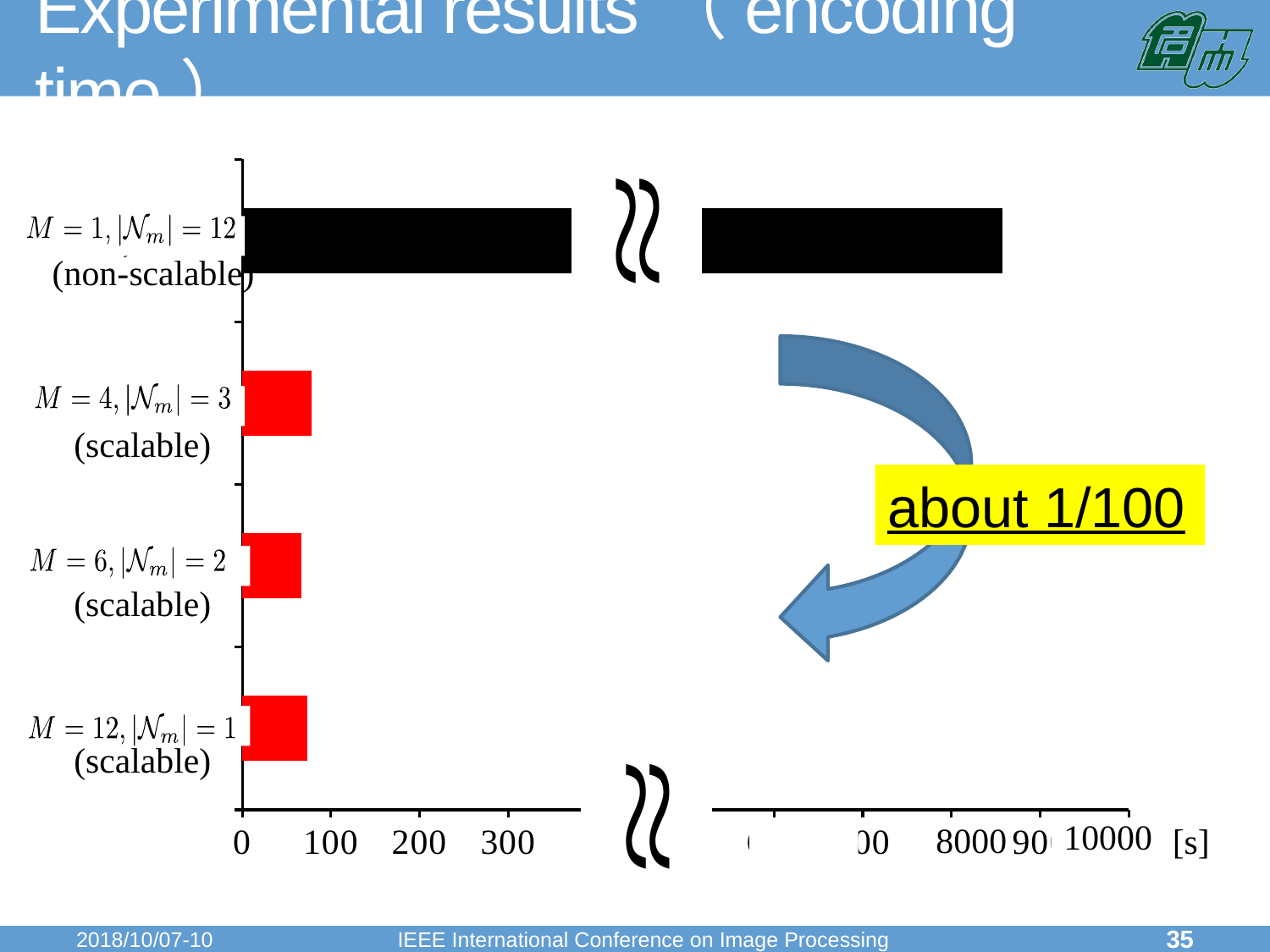
Is the encoding time for M = 4, |N_m| = 3 (scalable) greater or less than 100? less How many categories (bars) are plotted in the chart? 4 Is the encoding time for M = 1, |N_m| = 12 (non-scalable) greater or less than 1000? greater What unit is shown on the x axis of the chart? [s] Is the encoding time for M = 1, |N_m| = 12 (non-scalable) greater or less than 300? greater What kind of chart is shown on the slide? bar chart What colour is the bar for the non-scalable case (M = 1, |N_m| = 12)? black Which has the larger encoding time: M = 1, |N_m| = 12 (non-scalable) or M = 4, |N_m| = 3 (scalable)? M = 1, |N_m| = 12 (non-scalable) Which category has the longest bar (highest encoding time)? M = 1, |N_m| = 12 (non-scalable)